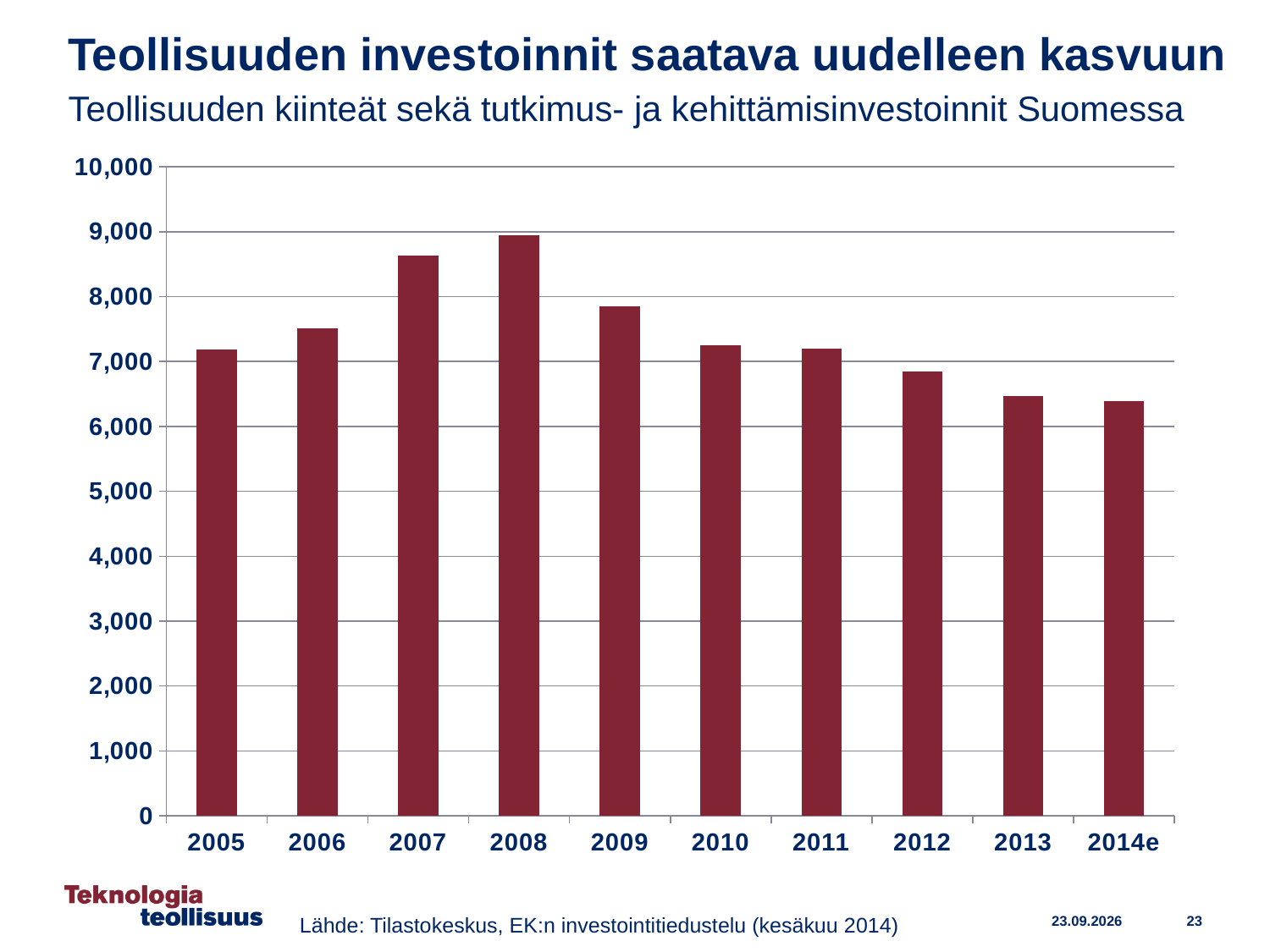
Which is larger, the value for 2007 or the value for 2009? 2007 Is the value for 2009 greater or less than 8,000? less Is the value for 2012 greater or less than 7,000? less What is the label of the last category on the x axis? 2014e Is the value for 2008 greater or less than 8,000? greater Which year has the highest value in the chart? 2008 Do the values rise or fall from 2005 to 2008? rise Do the values rise or fall from 2008 to 2014e? fall How many years (categories) are shown on the x axis of the chart? 10 What kind of chart is shown on the slide? bar chart